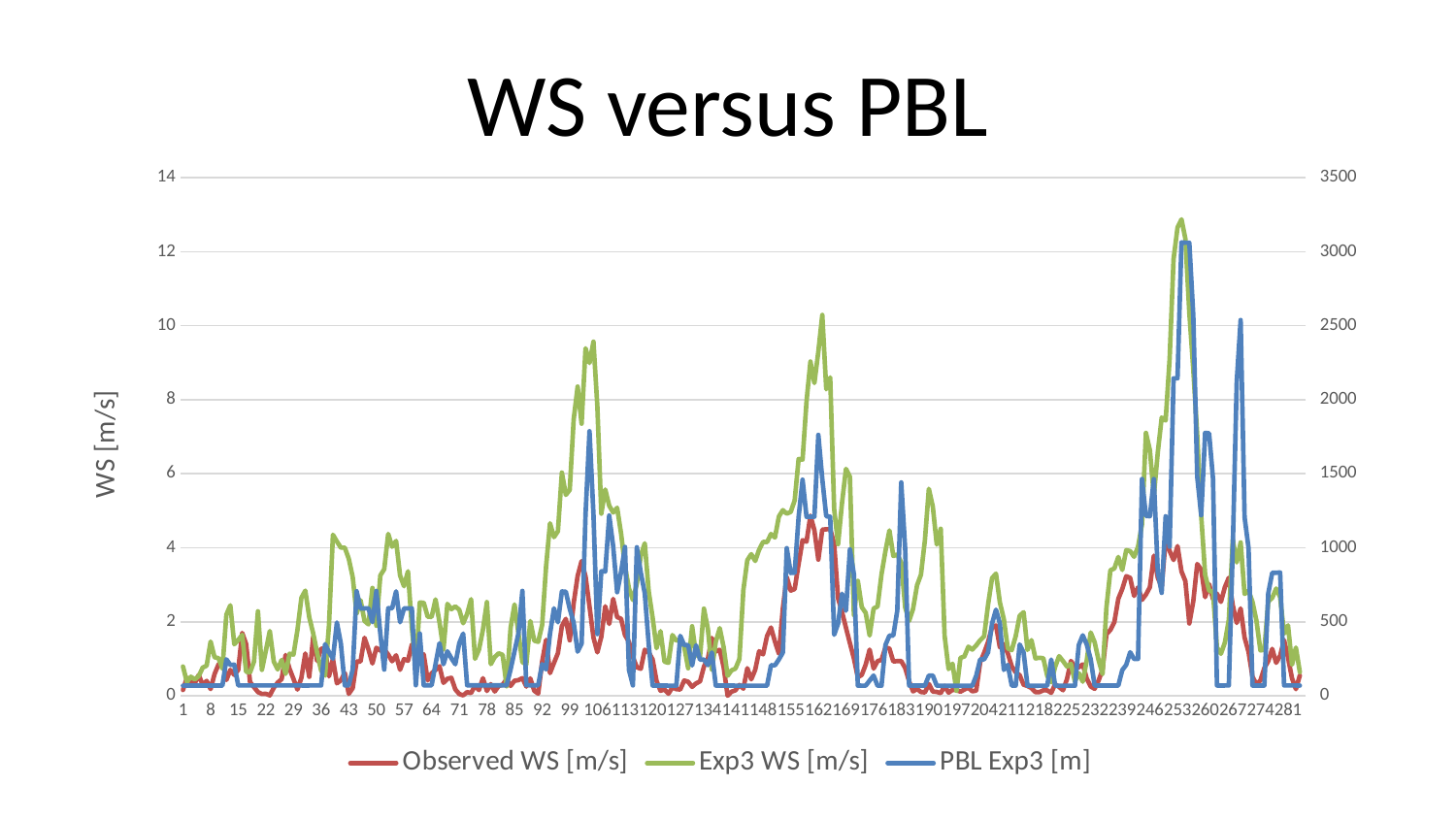
Is the highest value of the Observed WS [m/s] series greater or less than 6 on the left axis? less Of the two wind speed series, which reaches the higher peak on the left axis: Observed WS [m/s] or Exp3 WS [m/s]? Exp3 WS [m/s] What is the maximum value shown on the right vertical axis? 3500 What is the title of the chart? WS versus PBL Is the highest peak of the PBL Exp3 [m] series greater or less than 2500 on the right axis? greater What is the label on the left vertical axis? WS [m/s] Is the Observed WS [m/s] value at x = 1 greater or less than 2? less What kind of chart is shown on the slide? line chart Which wind speed series has the lowest maximum value on the left axis? Observed WS [m/s] How many series does the legend list? 3